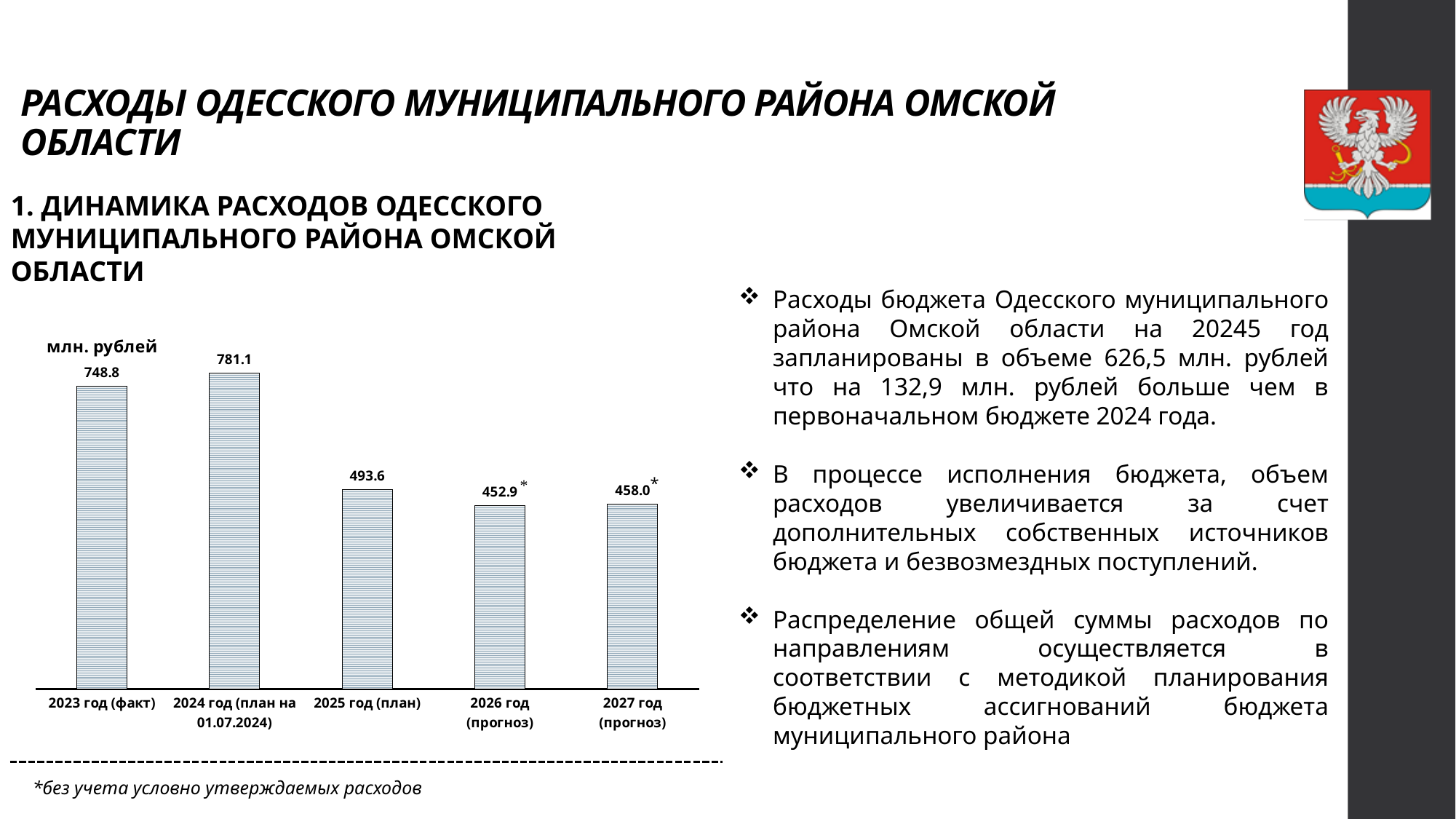
What is the difference between the values for 2025 год (план) and 2026 год (прогноз)? 40.7 What kind of chart is shown on the slide? Bar chart Which is larger, the value for 2023 год (факт) or the value for 2025 год (план)? 2023 год (факт) Which category has the highest value? 2024 год (план на 01.07.2024) What is the difference between the values for 2024 год (план на 01.07.2024) and 2023 год (факт)? 32.3 What is the value for 2024 год (план на 01.07.2024)? 781.1 How many categories are shown on the chart? 5 What is the value for 2023 год (факт)? 748.8 What unit is indicated for the values on the chart? млн. рублей Which category has the lowest value? 2026 год (прогноз) What is the value for 2025 год (план)? 493.6 What is the value for 2027 год (прогноз)? 458.0